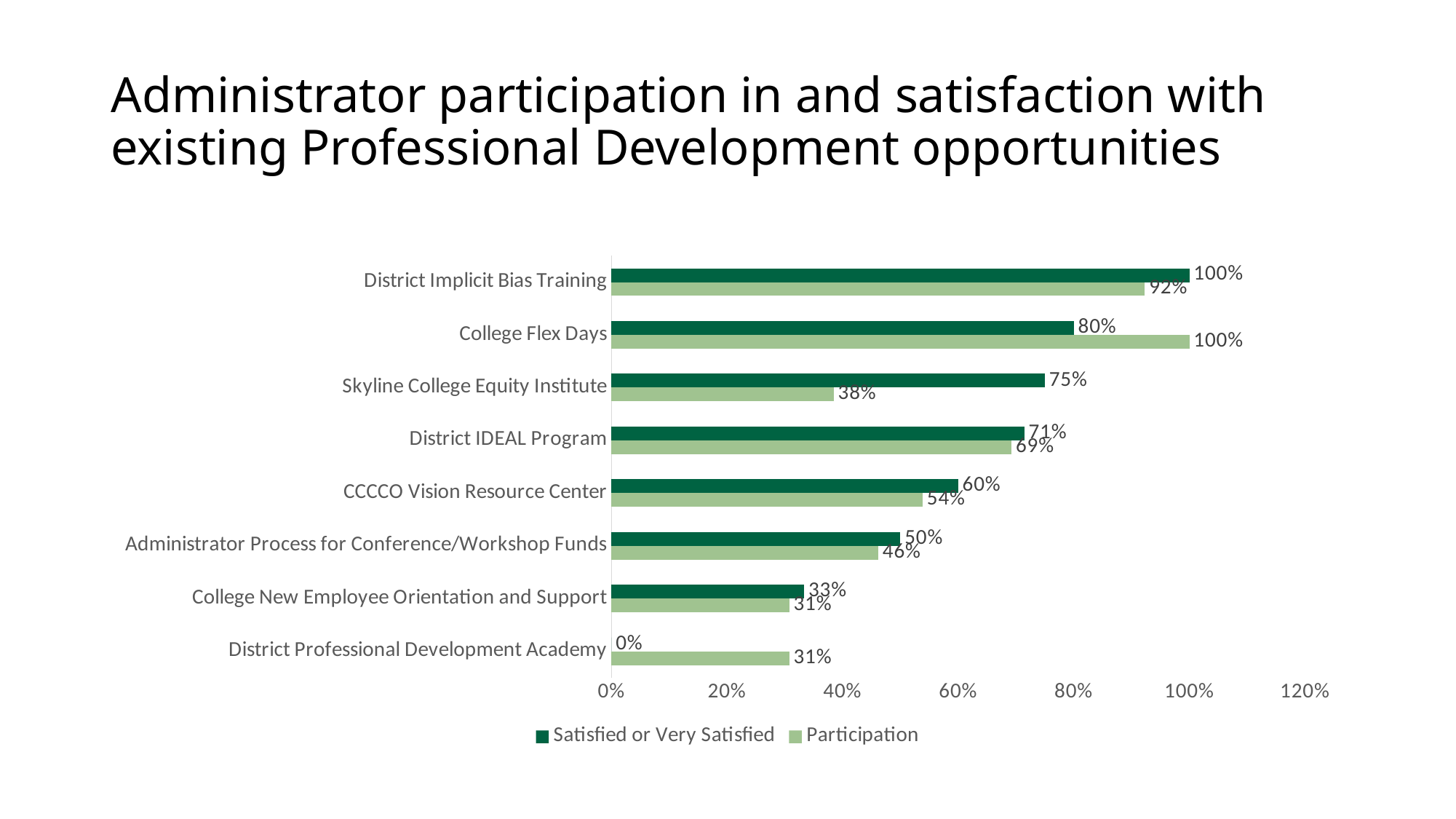
For College Flex Days, which is larger: the Satisfied or Very Satisfied value or the Participation value? Participation What is the Participation value for Skyline College Equity Institute? 38% What is the Satisfied or Very Satisfied value for College Flex Days? 80% How many series does the legend list? 2 What kind of chart is shown on the slide? Bar chart Is the Participation value for CCCCO Vision Resource Center greater or less than 40%? greater Which category has the highest Participation value? College Flex Days Which category has the lowest Satisfied or Very Satisfied value? District Professional Development Academy What is the Participation value for District Professional Development Academy? 31% What is the difference between the Satisfied or Very Satisfied and Participation values for Skyline College Equity Institute? 37% Which series is shown in the darker green colour? Satisfied or Very Satisfied How many categories are shown on the chart? 8